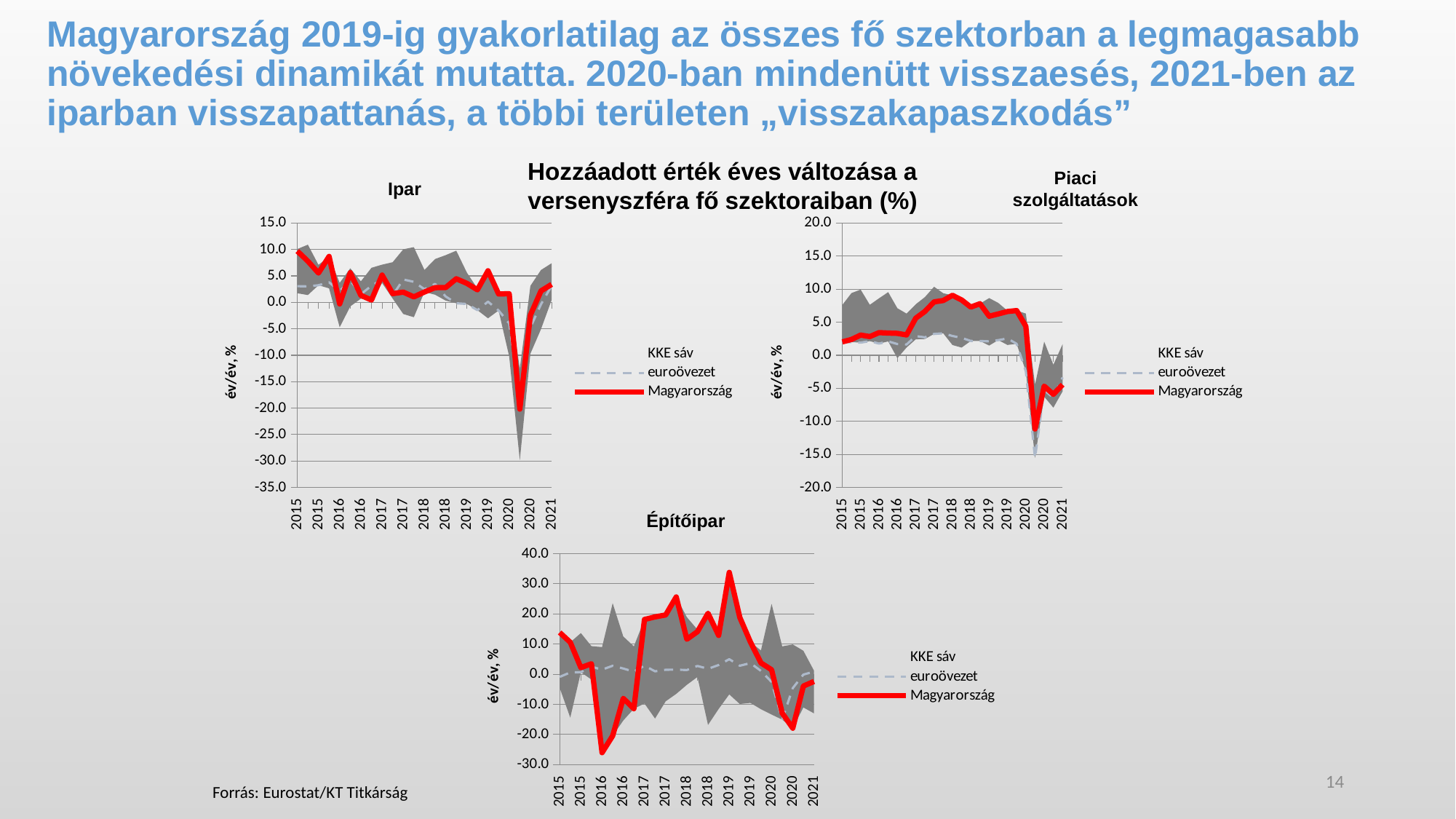
In the 'Építőipar' chart, is the lowest value of the Magyarország line in 2016 greater or less than -20.0? less How many series does the legend of the 'Építőipar' chart list? 3 What is the overall title shown above the three charts? Hozzáadott érték éves változása a versenyszféra fő szektoraiban (%) In the 'Ipar' chart, is the lowest value of the Magyarország line in 2020 greater or less than -10.0? less In the 'Építőipar' chart, in which year does the Magyarország line reach its lowest value? 2016 In the 'Építőipar' chart, in which year does the Magyarország line reach its highest value? 2019 In the 'Ipar' chart, what colour is the Magyarország line? red In the 'Építőipar' chart, is the highest value of the Magyarország line in 2019 greater or less than 30.0? greater What kind of chart is the 'Ipar' chart? combination area and line chart In the 'Építőipar' chart, at the 2019 peak, which is higher: the Magyarország line or the euroövezet line? Magyarország In the 'Piaci szolgáltatások' chart, does the Magyarország line rise or fall from 2019 to 2020? fall